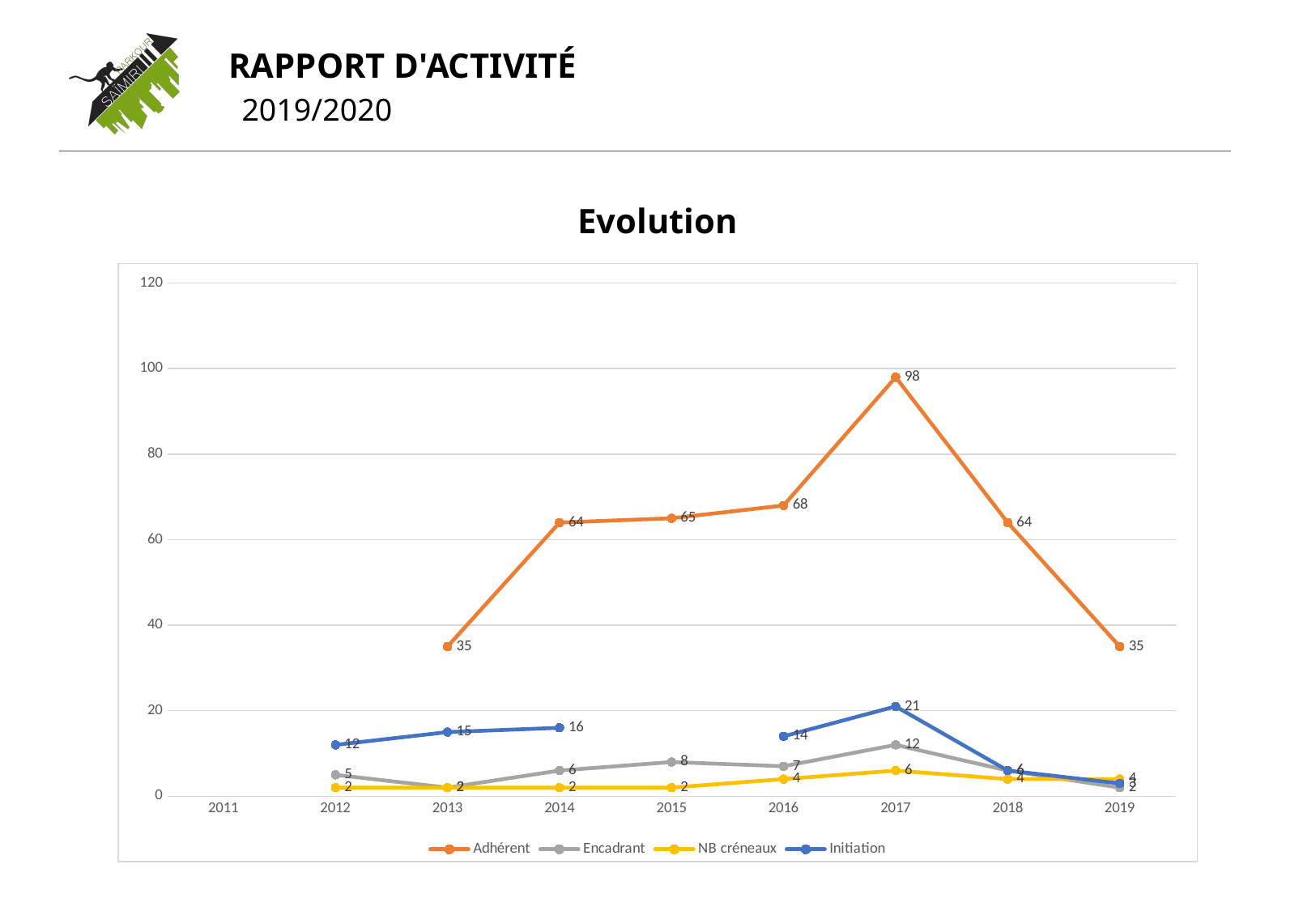
What is the Encadrant value for 2015? 8 What is the title of the chart? Evolution What is the NB créneaux value for 2017? 6 What type of chart is shown on the slide? line chart Which is larger in 2016, the Initiation value or the Encadrant value? Initiation How many series does the legend list? 4 What is the difference between the Adhérent values for 2017 and 2018? 34 What is the Initiation value for 2017? 21 In which year is the Adhérent value highest? 2017 What is the Adhérent value for 2017? 98 Does the Adhérent value rise or fall from 2017 to 2019? fall What is the Adhérent value for 2013? 35